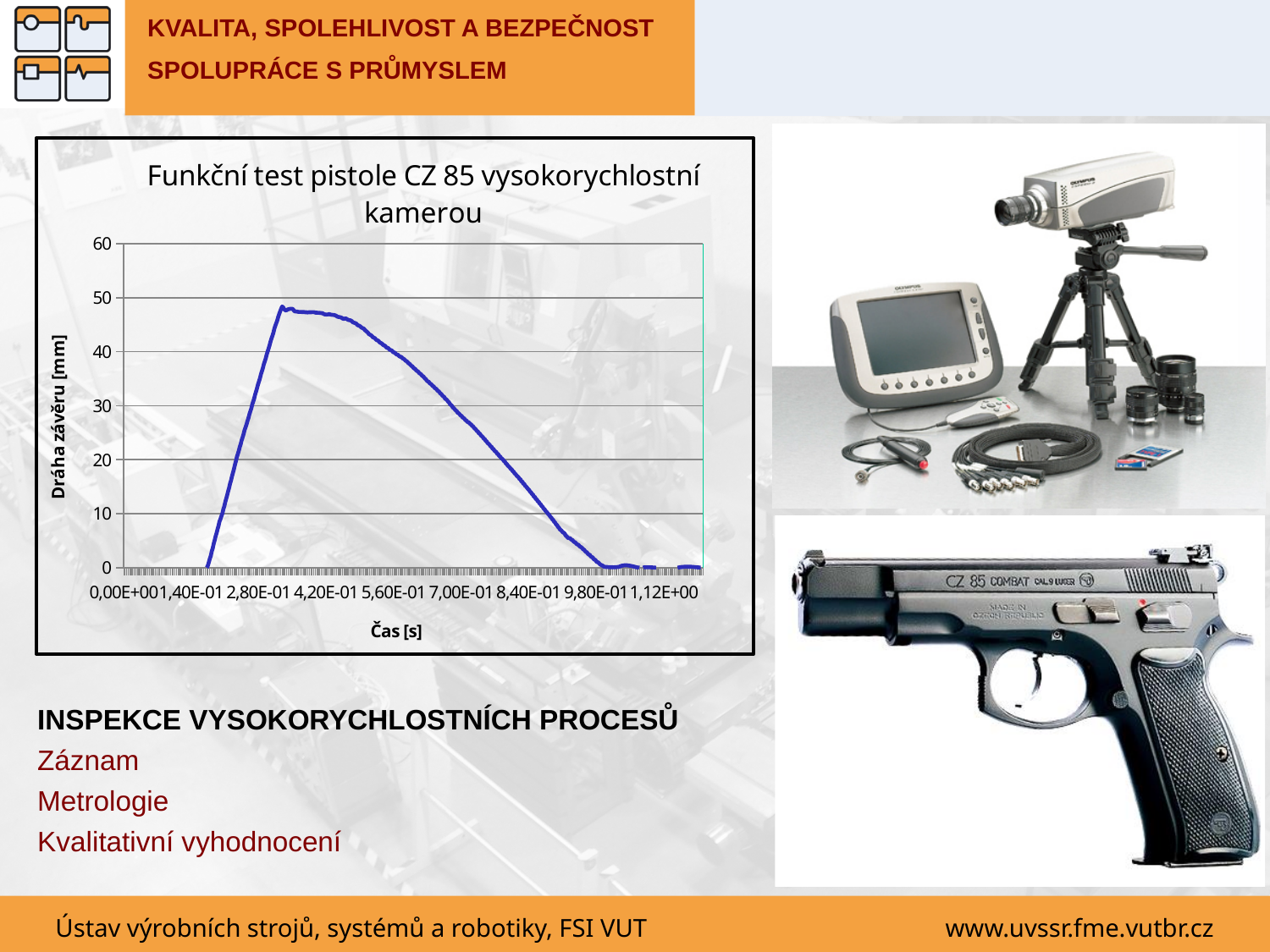
Which is larger, the value of the curve at time 4,20E-01 or at time 8,40E-01? 4,20E-01 What kind of chart is shown on the slide? line chart Is the peak value of the curve greater or less than 40? greater Is the peak value of the curve greater or less than 50? less What is the label of the vertical axis of the chart? Dráha závěru [mm] What is the highest value shown on the vertical axis of the chart? 60 Is the value of the curve at time 7,00E-01 greater or less than 30? less What is the title of the chart? Funkční test pistole CZ 85 vysokorychlostní kamerou Does the curve rise or fall between time 2,80E-01 and 4,20E-01? rise Does the curve rise or fall between time 5,60E-01 and 9,80E-01? fall